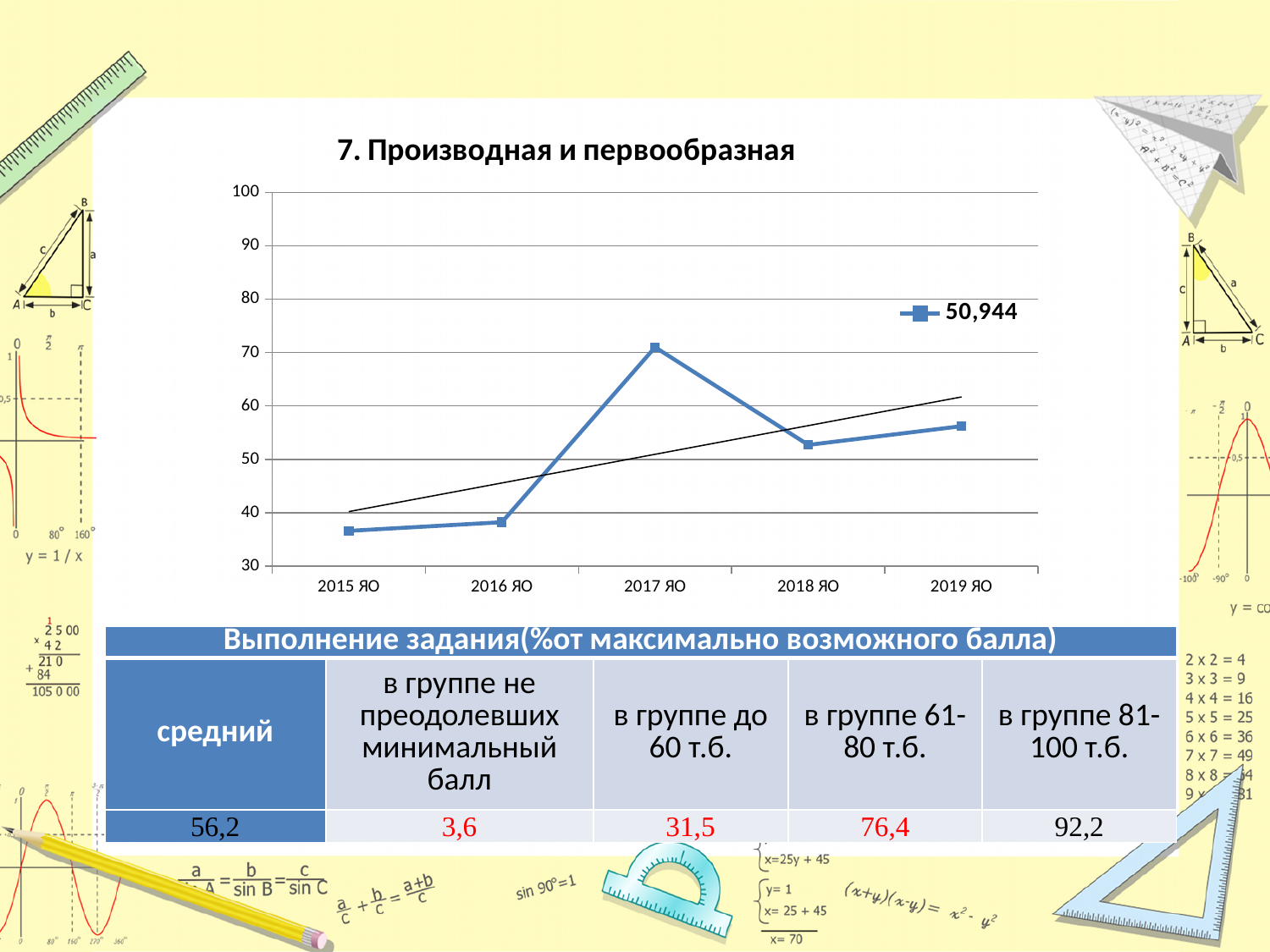
Is the value for 2017 ЯО greater or less than 60? greater What kind of chart is shown on the slide? line chart Is the value for 2015 ЯО greater or less than 40? less Is the value for 2019 ЯО greater or less than 60? less Does the plotted line rise or fall from 2017 ЯО to 2018 ЯО? fall How many series does the chart legend list? 1 What is the title of the chart? 7. Производная и первообразная Which year has the highest value on the chart? 2017 ЯО How many data points are plotted along the x axis of the chart? 5 What label does the legend show for the plotted series? 50,944 Which is larger, the value for 2017 ЯО or the value for 2018 ЯО? 2017 ЯО